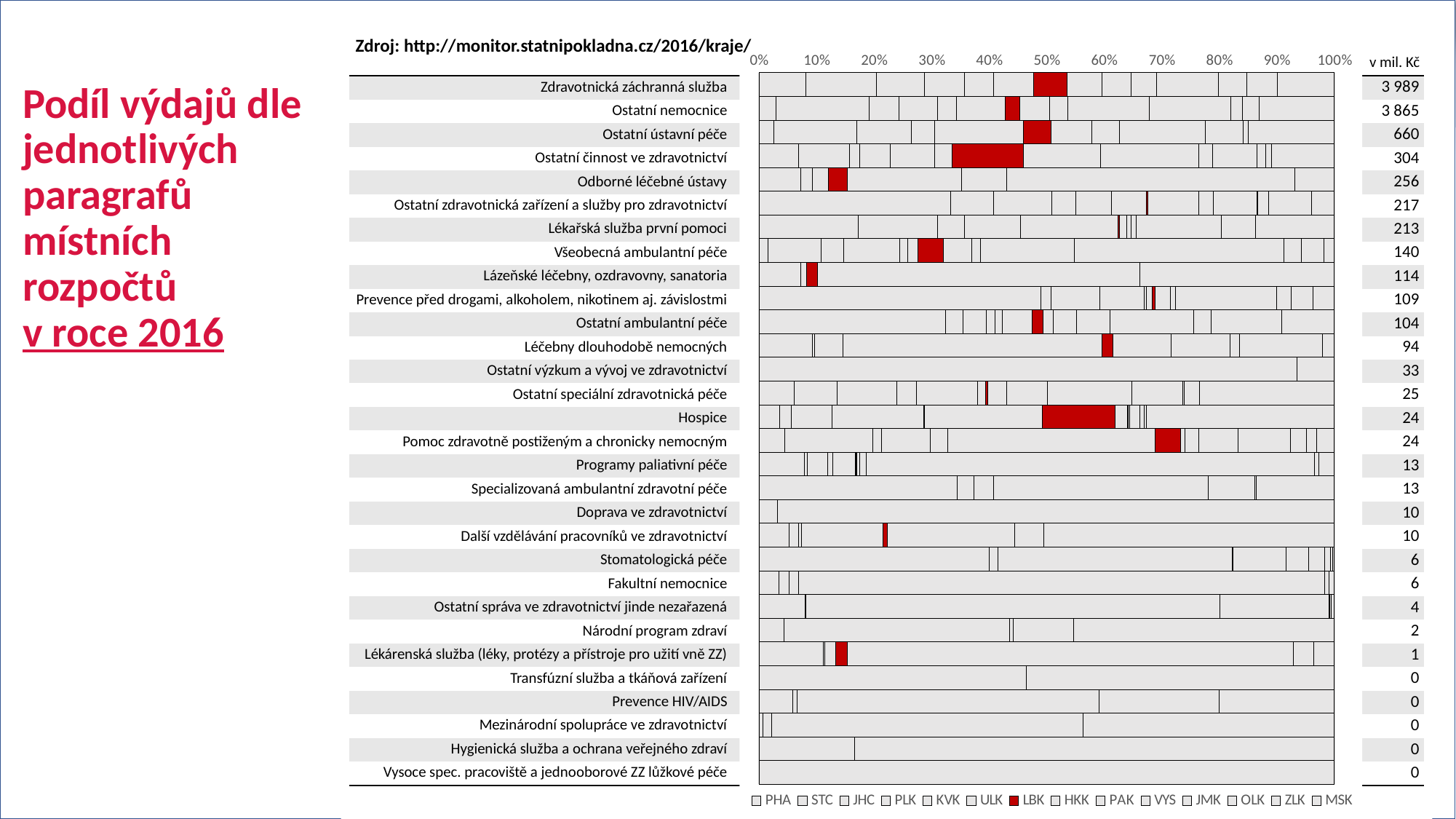
How many categories (rows) are plotted in the chart? 30 How many series does the legend list? 14 What is the difference in mil. Kč between Zdravotnická záchranná služba and Ostatní nemocnice? 124 Which category has the highest value in mil. Kč? Zdravotnická záchranná služba What kind of chart is shown on the slide? Stacked bar chart What is the value in mil. Kč shown for Zdravotnická záchranná služba? 3 989 Which has the larger value in mil. Kč: Odborné léčebné ústavy or Ostatní činnost ve zdravotnictví? Ostatní činnost ve zdravotnictví What is the value in mil. Kč shown for Ostatní nemocnice? 3 865 How many categories show a value of 0 mil. Kč? 5 Is the LBK share for Zdravotnická záchranná služba greater or less than 10%? less Which series is highlighted in red in the chart? LBK What is the value in mil. Kč shown for Hospice? 24